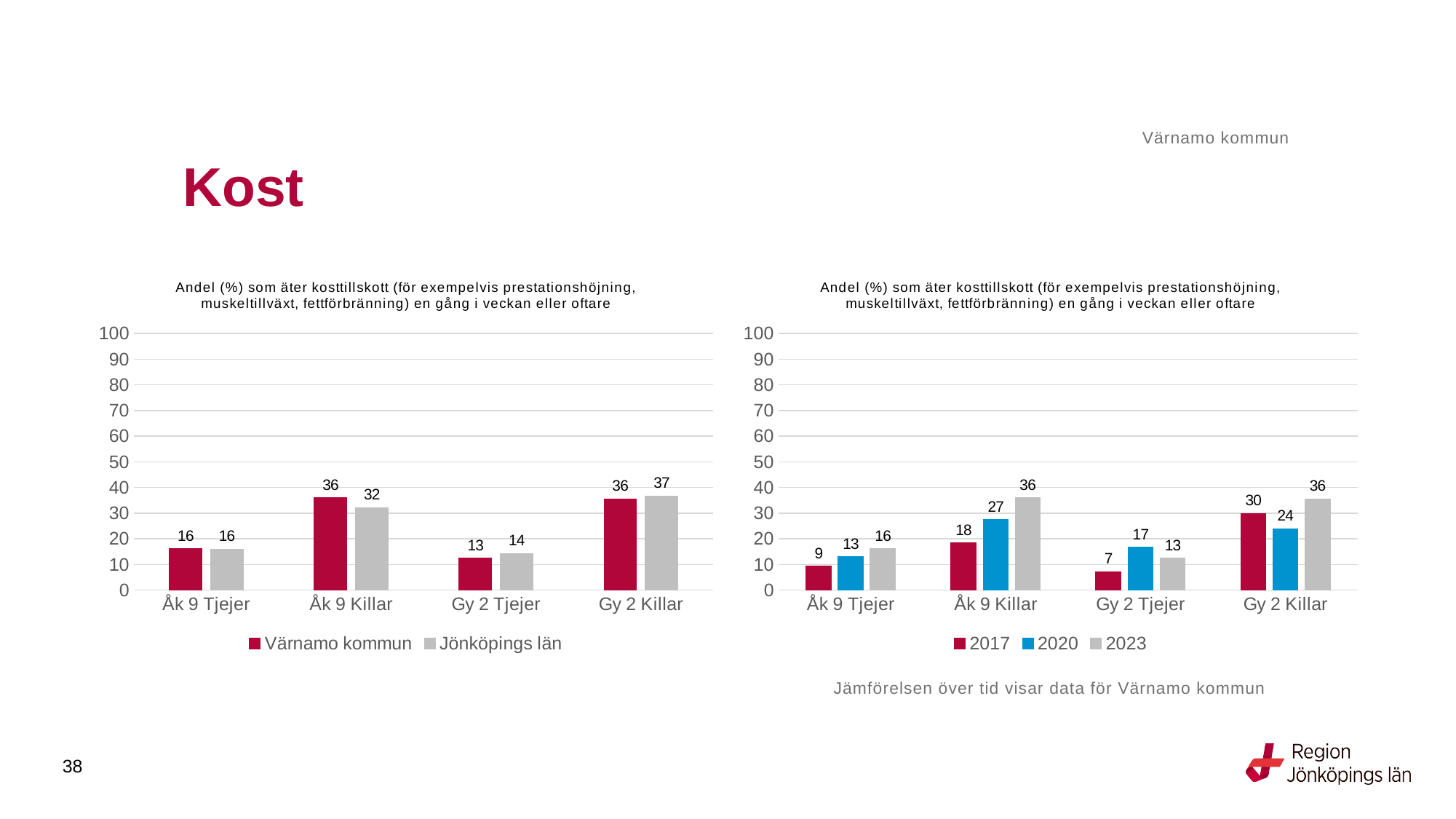
In the right chart, which category has the highest value for 2023? Åk 9 Killar and Gy 2 Killar (both 36) In the left chart, how many series does the legend list? 2 In the right chart, what is the difference between the 2023 and 2017 values for Åk 9 Killar? 18 In the right chart, how many categories are shown on the x axis? 4 In the right chart, what is the value for 2020 for Gy 2 Tjejer? 17 In the right chart, is the value for 2017 for Gy 2 Killar larger or smaller than the value for 2020 for Gy 2 Killar? larger In the right chart, what is the value for 2017 for Åk 9 Tjejer? 9 In the left chart, what is the value for Jönköpings län for Gy 2 Tjejer? 14 In the left chart, what is the difference between Värnamo kommun and Jönköpings län for Åk 9 Killar? 4 What kind of chart is the right chart? Bar chart In the left chart, what is the value for Värnamo kommun for Åk 9 Killar? 36 In the left chart, which category has the lowest value for Värnamo kommun? Gy 2 Tjejer